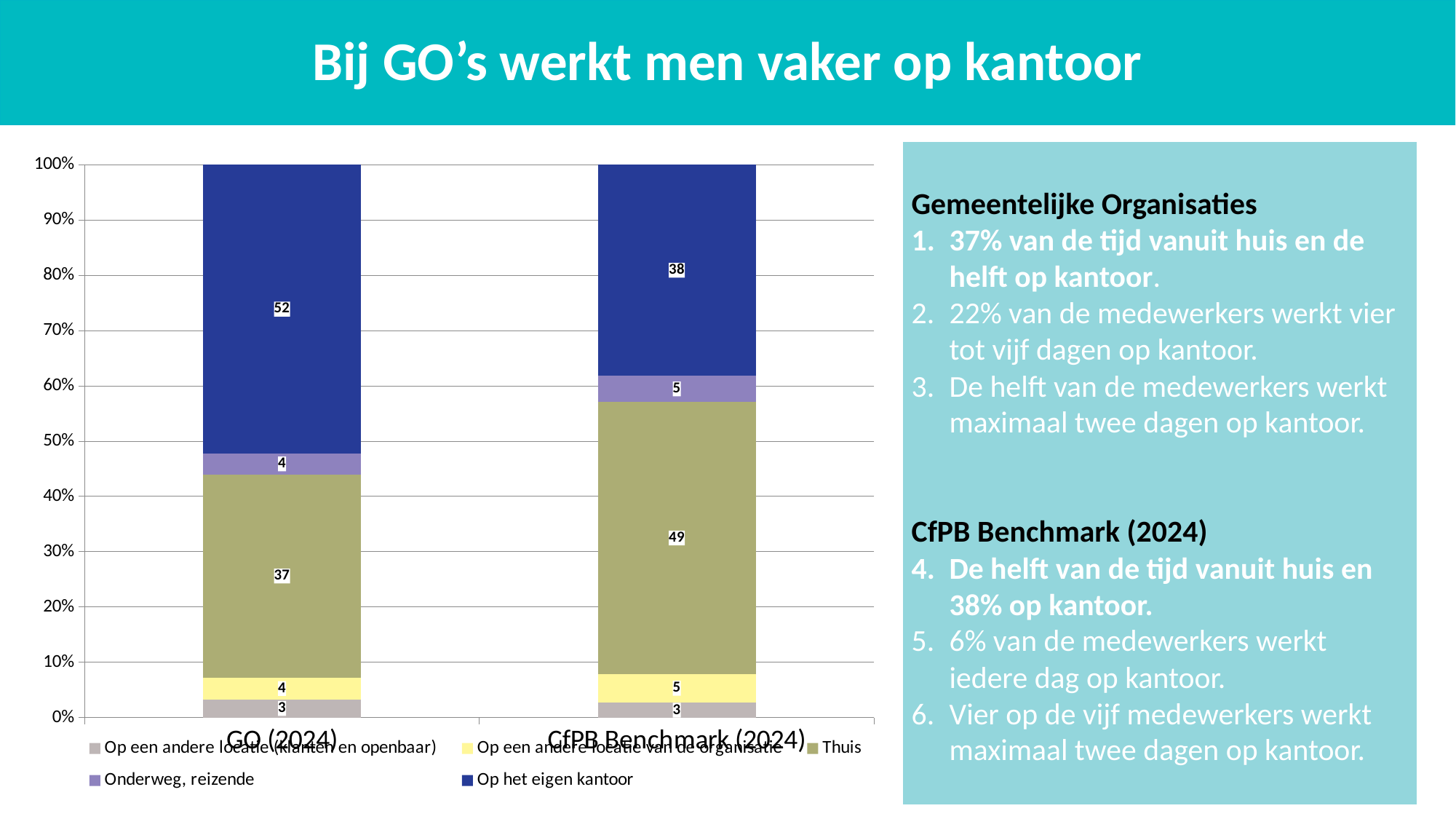
What is the value for "Onderweg, reizende" in the GO (2024) bar? 4 Which bar has the larger "Thuis" value, GO (2024) or CfPB Benchmark (2024)? CfPB Benchmark (2024) How many series does the legend list? 5 Which segment is the largest in the CfPB Benchmark (2024) bar? Thuis What is the value for "Thuis" in the CfPB Benchmark (2024) bar? 49 What is the difference between the "Op het eigen kantoor" values for GO (2024) and CfPB Benchmark (2024)? 14 What is the value for "Op het eigen kantoor" in the GO (2024) bar? 52 Which segment is the largest in the GO (2024) bar? Op het eigen kantoor What is the value for "Op een andere locatie van de organisatie" in the CfPB Benchmark (2024) bar? 5 How many bars (categories) are shown on the x axis? 2 What kind of chart is shown on the slide? stacked bar chart What is the title of the slide? Bij GO’s werkt men vaker op kantoor